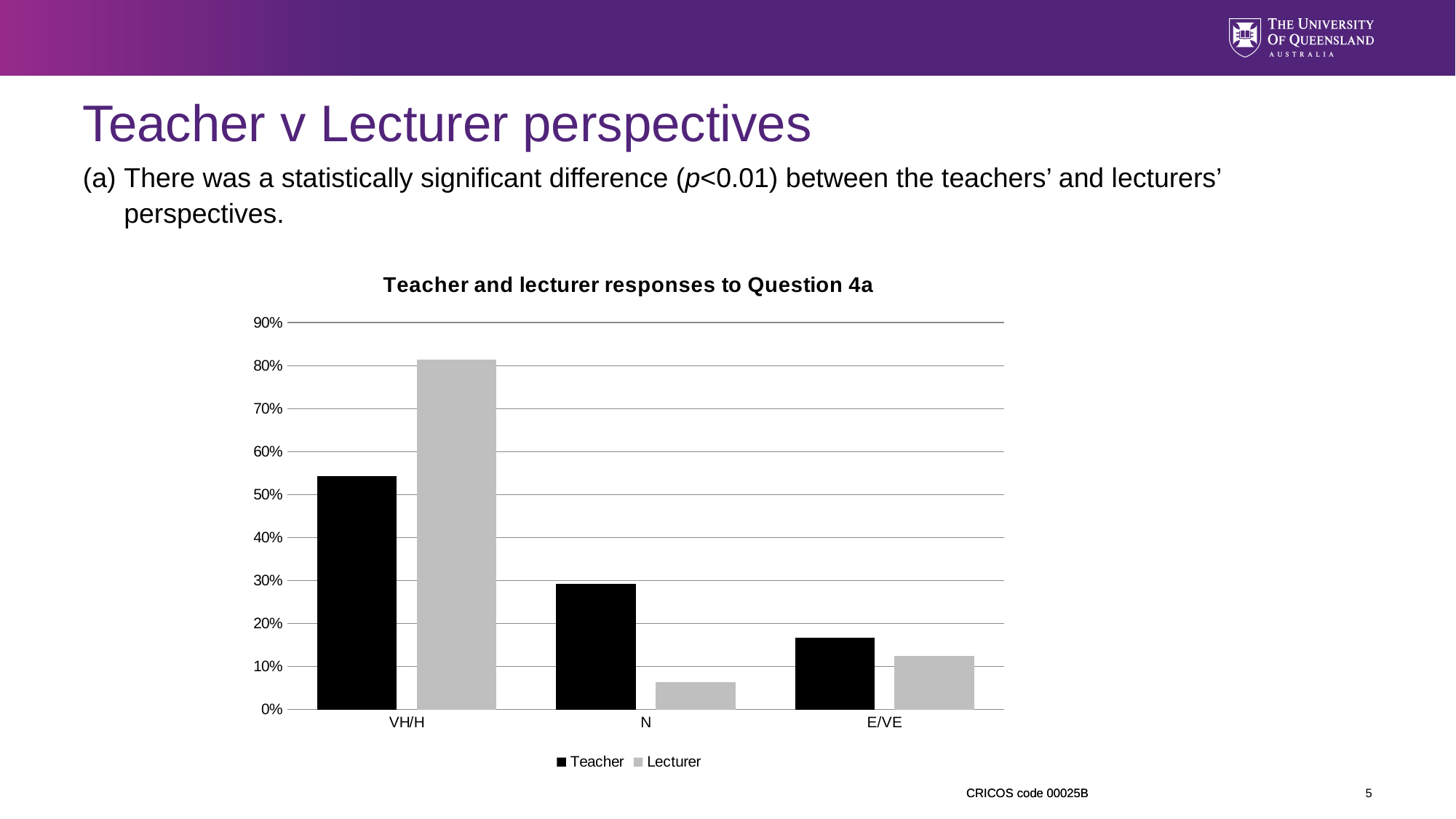
Which category has the lowest Teacher value? E/VE Which category has the highest Lecturer value? VH/H Which category has the lowest Lecturer value? N Which category has the highest Teacher value? VH/H What type of chart is shown on the slide? bar chart How many categories are shown on the x axis of the chart? 3 How many series does the chart legend list? 2 For the N category, which series has the larger value, Teacher or Lecturer? Teacher Is the Lecturer value for VH/H greater or less than 80%? greater What is the title of the chart? Teacher and lecturer responses to Question 4a For the VH/H category, which series has the larger value, Teacher or Lecturer? Lecturer